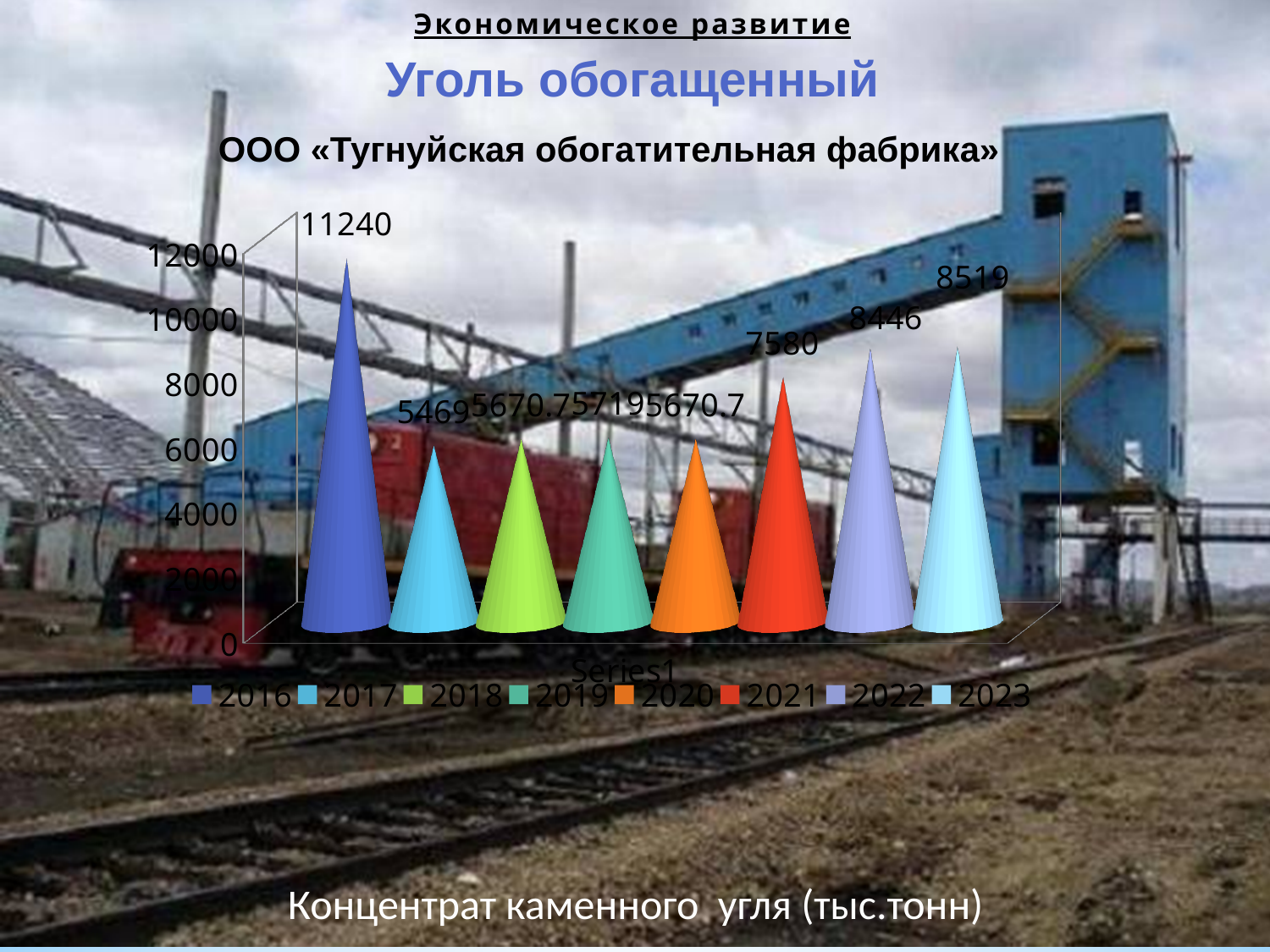
Which year has the lowest value? 2017 What is the value for 2021? 7580 Is the value for 2019 greater or less than 6000? less What is the value for 2016? 11240 Which is larger, the value for 2022 or the value for 2021? 2022 What is the value for 2022? 8446 Which year has the highest value? 2016 What is the value for 2023? 8519 How many years are shown in the chart? 8 What is the title of the chart? ООО «Тугнуйская обогатительная фабрика» What is the difference between the values for 2016 and 2021? 3660 What is the difference between the values for 2023 and 2022? 73